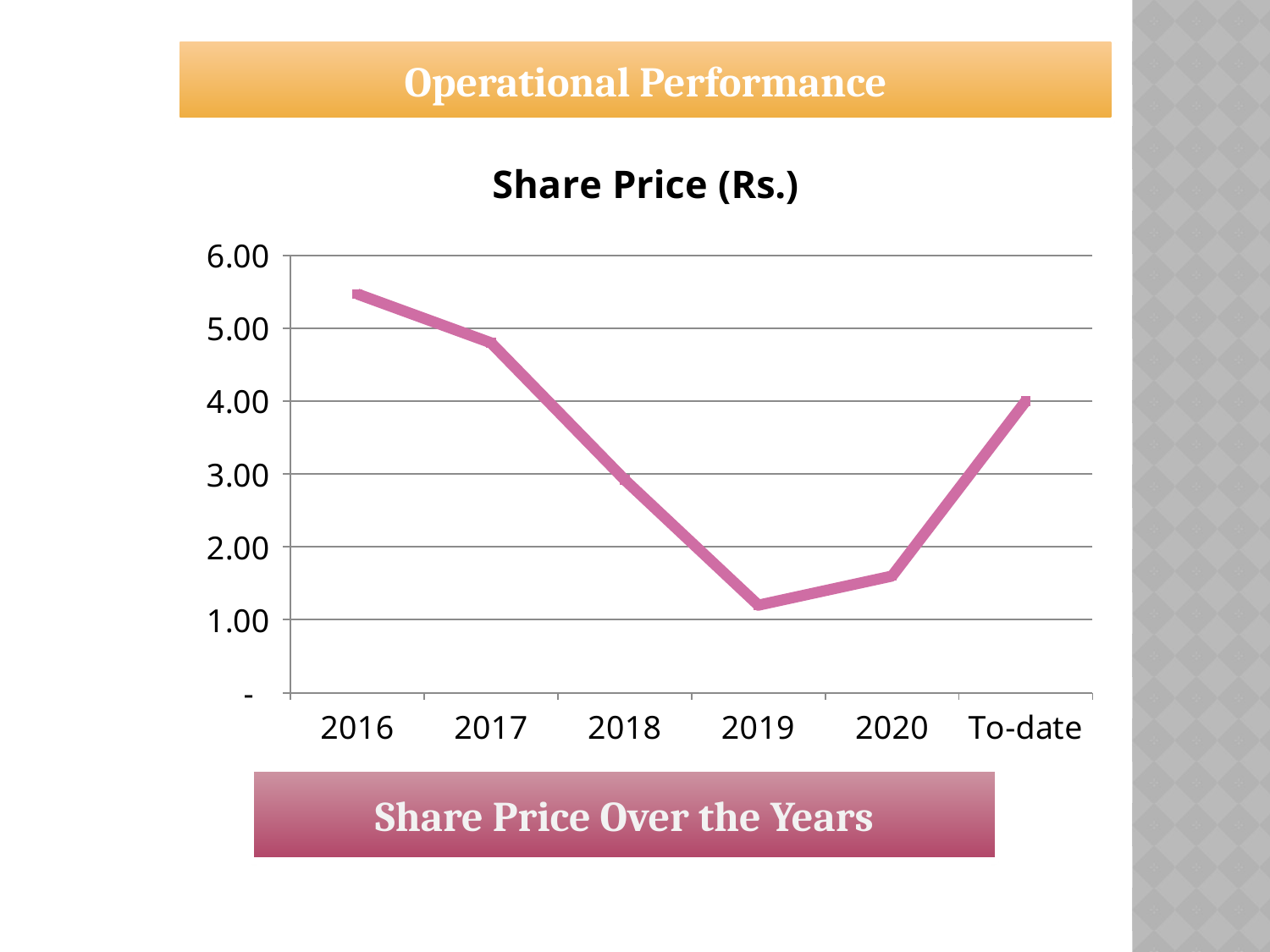
Which year has the highest share price? 2016 Is the share price for To-date greater or less than 3.00? greater What kind of chart is shown on the slide? line chart Is the share price for 2016 greater or less than 5.00? greater How many points are plotted along the x axis? 6 Is the share price for 2019 greater or less than 2.00? less Which is larger, the share price for 2019 or for 2020? 2020 Which is larger, the share price for 2016 or for 2017? 2016 Does the share price rise or fall from 2016 to 2019? fall What is the title of the chart? Share Price (Rs.) Which year has the lowest share price? 2019